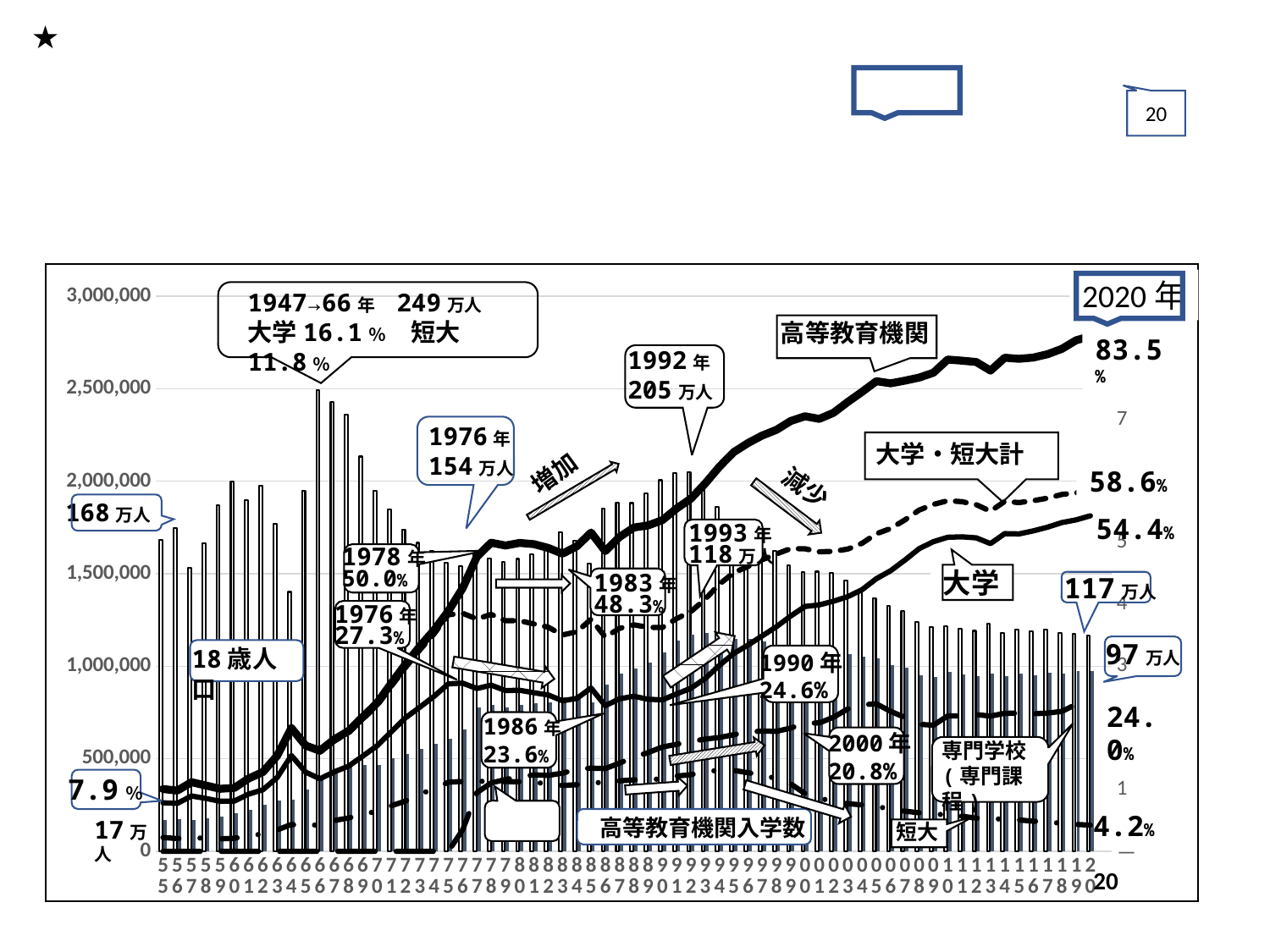
What 18歳人口 value is labelled for 1976年? 154万人 Among the 2020 rates labelled on the right side of the chart, which series has the lowest value? 短大 (4.2%) Which is larger: the 1978年 value of 50.0% or the 1983年 value of 48.3%? 1978年 (50.0%) What 18歳人口 value is labelled for 1992年? 205万人 What is the 2020 value shown for 大学・短大計 (university and junior college combined)? 58.6% What is the 2020 value shown for 専門学校 (専門課程)? 24.0% What is the highest tick value shown on the left vertical axis? 3,000,000 Among the 2020 rates labelled on the right side of the chart, which series has the highest value? 高等教育機関 (83.5%) What is the 2020 value shown for 短大 (junior college)? 4.2% What is the difference between the 2020 values for 大学・短大計 (58.6%) and 大学 (54.4%)? 4.2% What is the 2020 value shown for 大学 (university)? 54.4% What is the 2020 value shown for 高等教育機関 (higher education institutions) enrollment rate? 83.5%